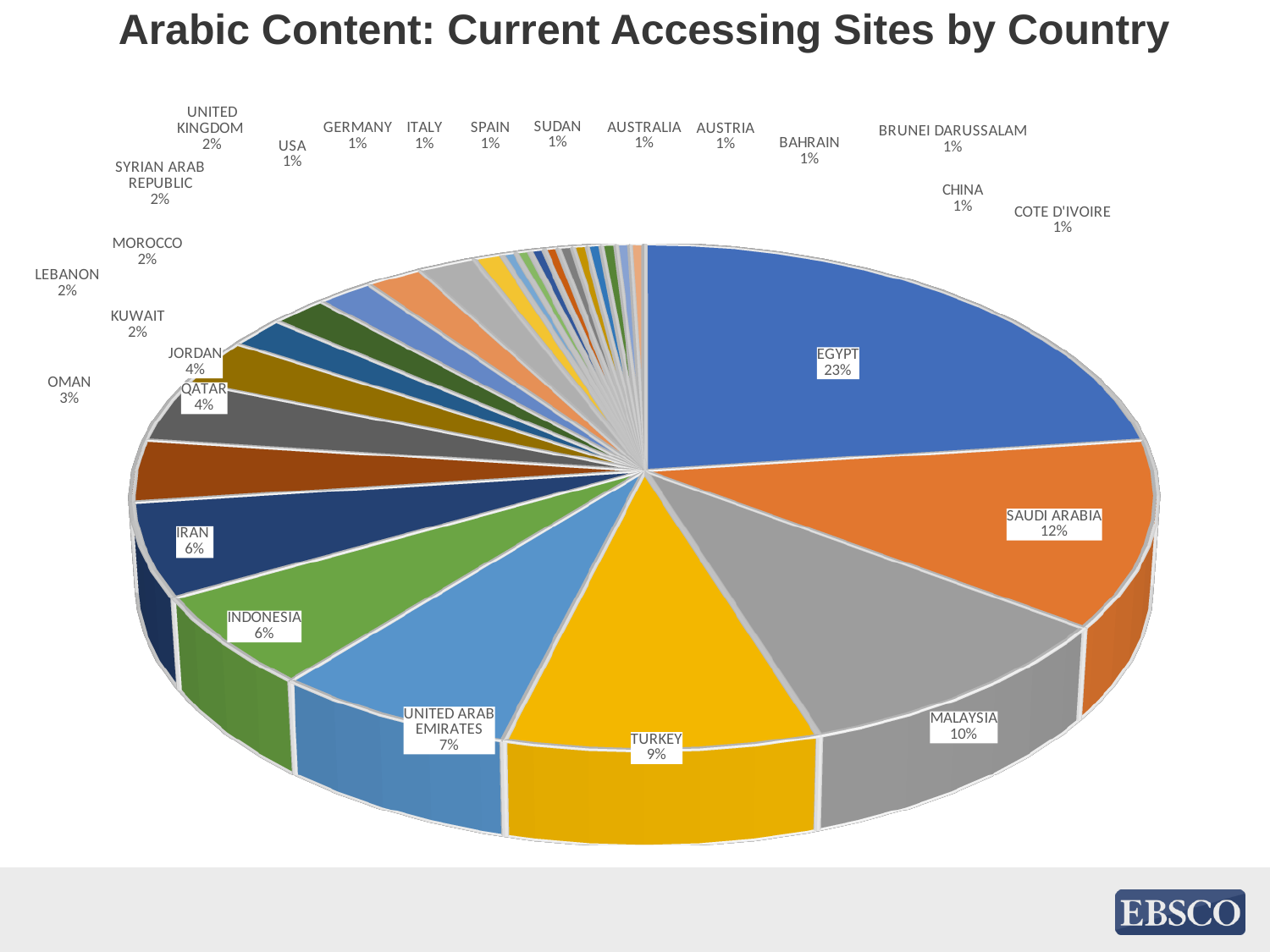
What is the difference between the shares of Egypt and Saudi Arabia? 11% What is the value shown for United Arab Emirates? 7% What is the value shown for Oman? 3% What kind of chart is shown on the slide? pie chart What is the difference between the shares of Indonesia and Qatar? 2% Which country has the largest slice of the pie? Egypt What is the title of the chart? Arabic Content: Current Accessing Sites by Country Which is larger, the share for Turkey or the share for Malaysia? Malaysia What is the value shown for Malaysia? 10% What share of the pie does Egypt account for? 23% What is the value shown for Turkey? 9% What is the value shown for Saudi Arabia? 12%